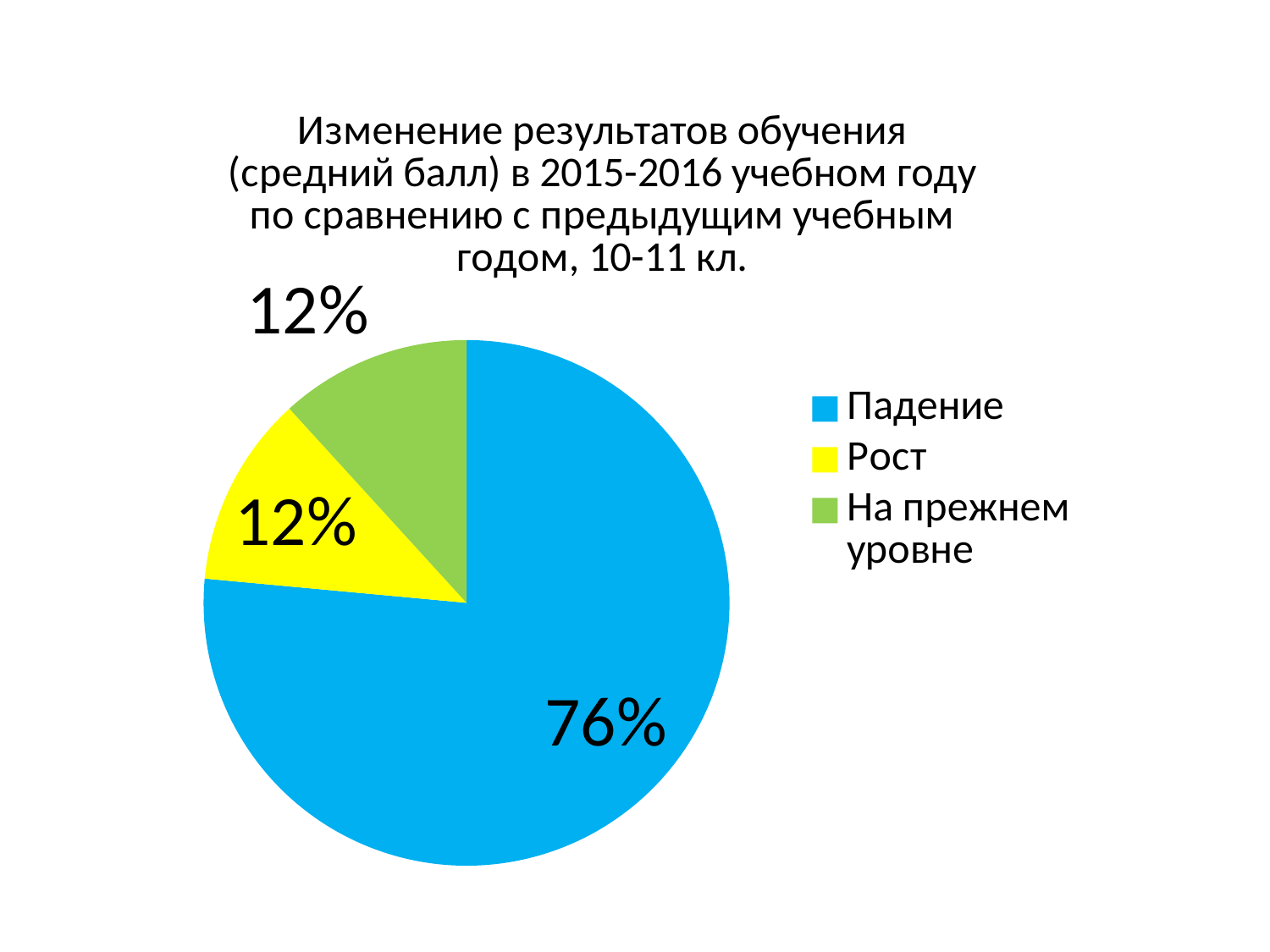
What share of the pie does the "Падение" slice represent? 76% What kind of chart is shown on the slide? pie chart What share of the pie does the "На прежнем уровне" slice represent? 12% Which is larger, the "Падение" slice or the "На прежнем уровне" slice? Падение How many slices does the pie chart have? 3 Which grade range (классы) does the chart title say the data covers? 10-11 кл. Is the share for "Падение" greater or less than 50%? greater What share of the pie does the "Рост" slice represent? 12% How many entries does the legend list? 3 What colour is the "Рост" slice in the pie chart? yellow What is the difference in percentage points between the "Падение" slice and the "Рост" slice? 64 Which category has the largest slice of the pie? Падение